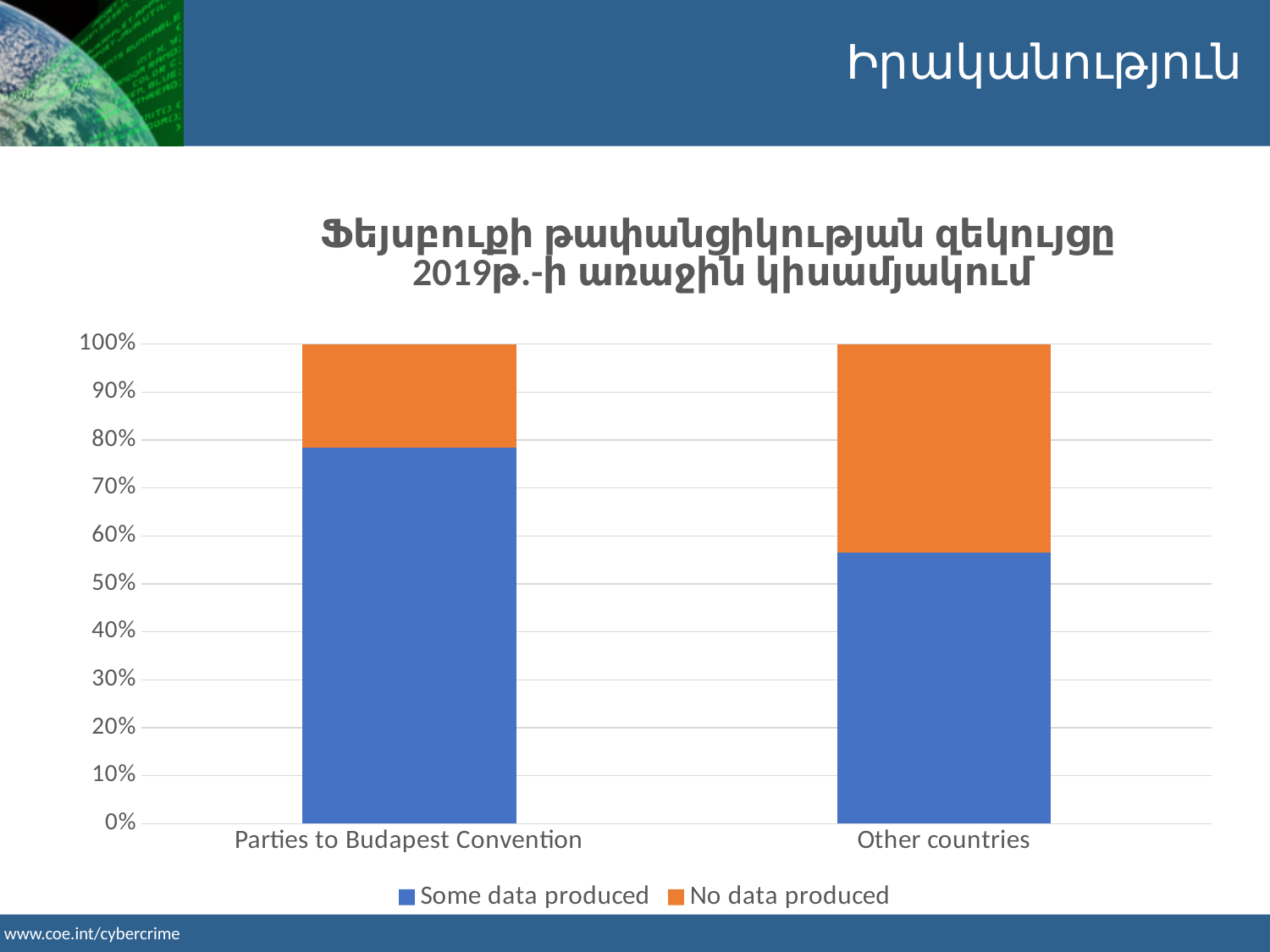
Which category has the larger 'Some data produced' share: Parties to Budapest Convention or Other countries? Parties to Budapest Convention Is the 'No data produced' share for Parties to Budapest Convention greater or less than 30%? less Which series is shown in orange in the chart? No data produced Which series is shown in blue in the chart? Some data produced How many categories are shown on the x axis of the chart? 2 How many series does the chart's legend list? 2 Is the 'No data produced' share for Other countries greater or less than 40%? greater Is the 'Some data produced' value for Parties to Budapest Convention greater or less than 70%? greater What is the total height of the stacked bar for Other countries? 100% Which category has the larger 'No data produced' share? Other countries What kind of chart is shown on the slide? Stacked bar chart